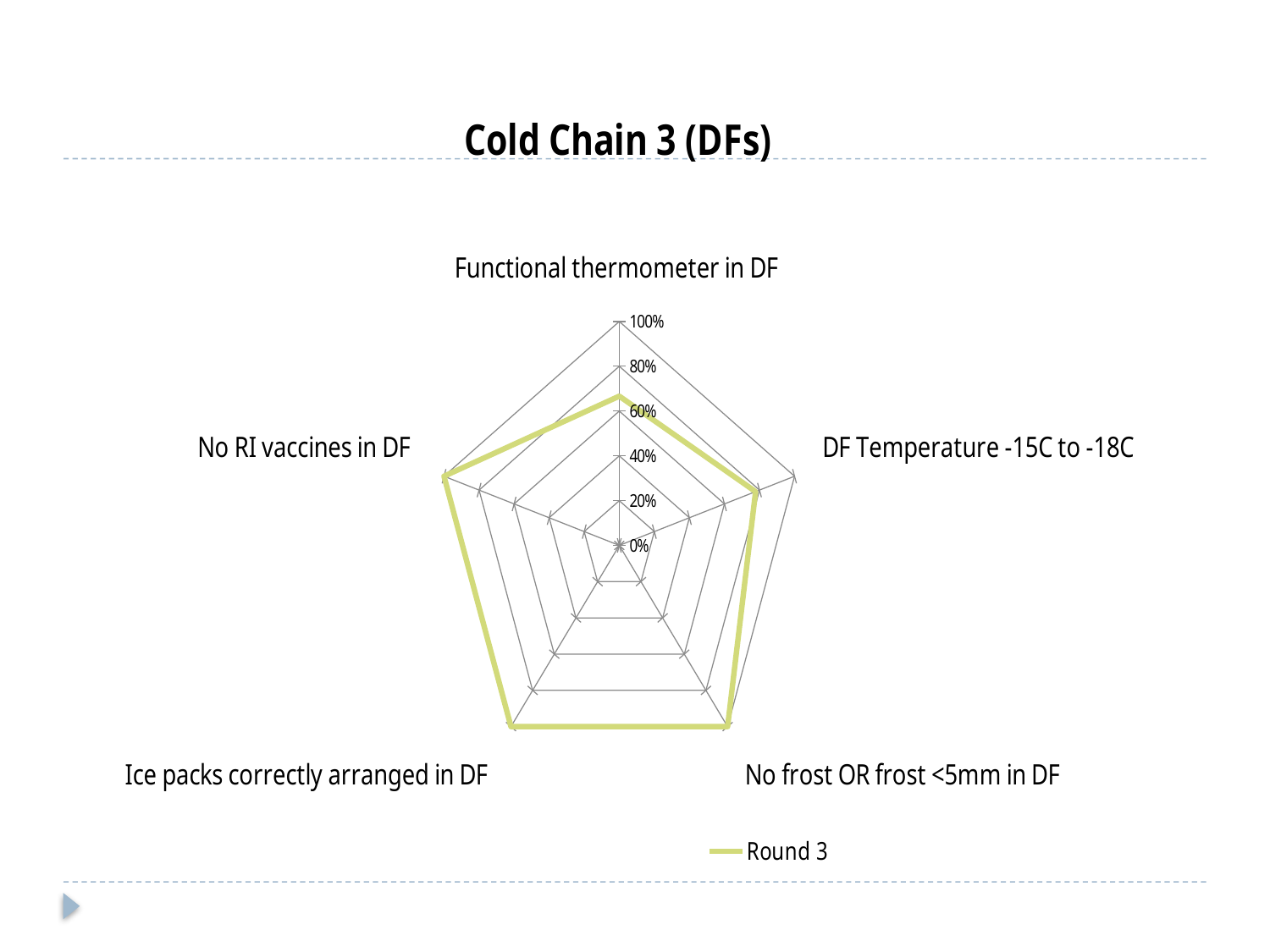
What is the title of the chart? Cold Chain 3 (DFs) Is the value for Functional thermometer in DF greater or less than 80%? less What series name is shown in the legend? Round 3 Which category has the lowest value for Round 3? Functional thermometer in DF Is the value for Ice packs correctly arranged in DF greater or less than 80%? greater Which is larger, the value for No frost OR frost <5mm in DF or the value for Functional thermometer in DF? No frost OR frost <5mm in DF How many series does the legend list? 1 Is the value for DF Temperature -15C to -18C greater or less than 60%? greater How many categories (axes) does the radar chart have? 5 What kind of chart is shown on the slide? Radar chart